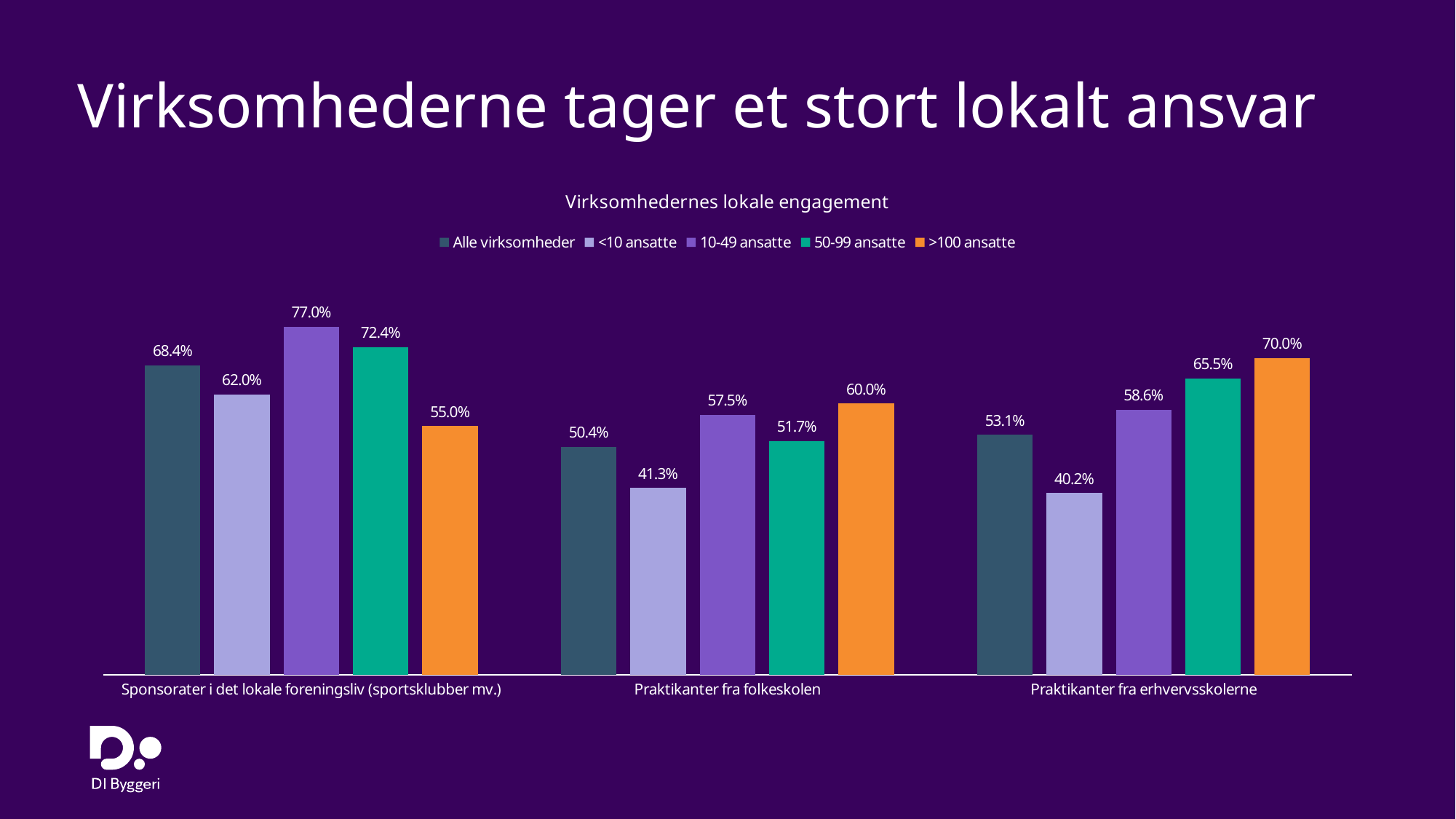
What is the value for '50-99 ansatte' in the 'Praktikanter fra folkeskolen' category? 51.7% What is the value for '10-49 ansatte' in the 'Sponsorater i det lokale foreningsliv (sportsklubber mv.)' category? 77.0% What is the title of the chart? Virksomhedernes lokale engagement What is the value for '<10 ansatte' in the 'Praktikanter fra folkeskolen' category? 41.3% Which series has the highest value in the 'Praktikanter fra erhvervsskolerne' category? >100 ansatte What is the value for '>100 ansatte' in the 'Praktikanter fra erhvervsskolerne' category? 70.0% Which is larger: the 'Alle virksomheder' value for 'Praktikanter fra folkeskolen' or for 'Praktikanter fra erhvervsskolerne'? Praktikanter fra erhvervsskolerne How many categories are shown on the x axis? 3 What is the difference between the '10-49 ansatte' and '>100 ansatte' values in the 'Sponsorater i det lokale foreningsliv (sportsklubber mv.)' category? 22.0% Which series has the lowest value in the 'Praktikanter fra folkeskolen' category? <10 ansatte What kind of chart is shown on the slide? Bar chart How many series does the legend list? 5